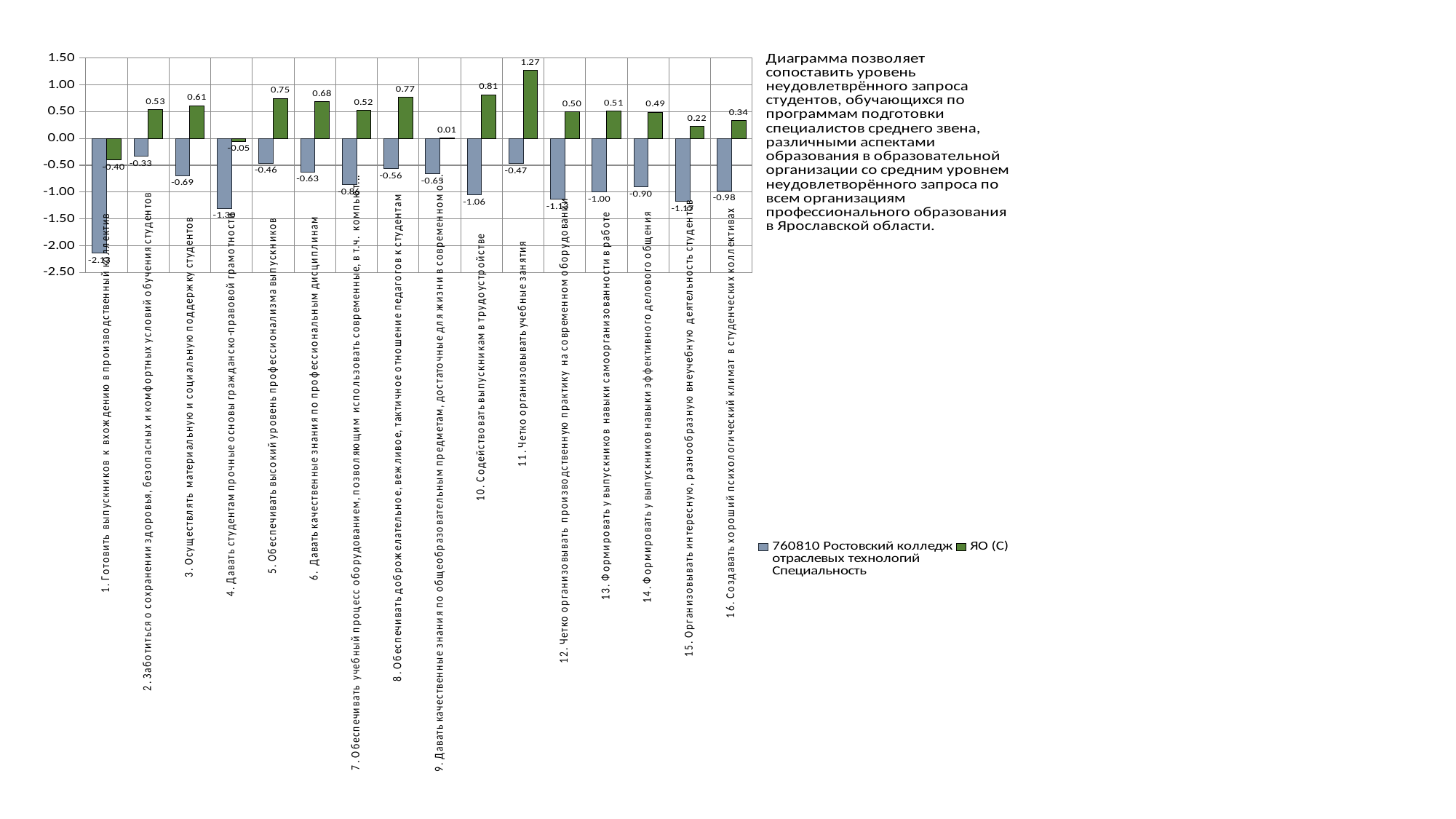
What is the value of the 760810 Ростовский колледж отраслевых технологий series for category 13 (Формировать у выпускников навыки самоорганизованности в работе)? -1.00 Is the value of the 760810 Ростовский колледж отраслевых технологий series for category 1 greater or less than -2.00? less What is the value of the ЯО (С) series for category 9 (Давать качественные знания по общеобразовательным предметам)? 0.01 Which category has the lowest value for the ЯО (С) series? 1. Готовить выпускников к вхождению в производственный коллектив For category 8 (Обеспечивать доброжелательное, вежливое, тактичное отношение педагогов к студентам), which series has the larger value? ЯО (С) Which category has the highest value for the ЯО (С) series? 11. Четко организовывать учебные занятия What is the difference between the ЯО (С) values for category 11 and category 10? 0.46 Which category has the lowest value for the 760810 Ростовский колледж отраслевых технологий series? 1. Готовить выпускников к вхождению в производственный коллектив What is the value of the ЯО (С) series for category 11 (Четко организовывать учебные занятия)? 1.27 How many series does the legend list? 2 How many categories are plotted along the x axis? 16 What type of chart is shown on the slide? bar chart